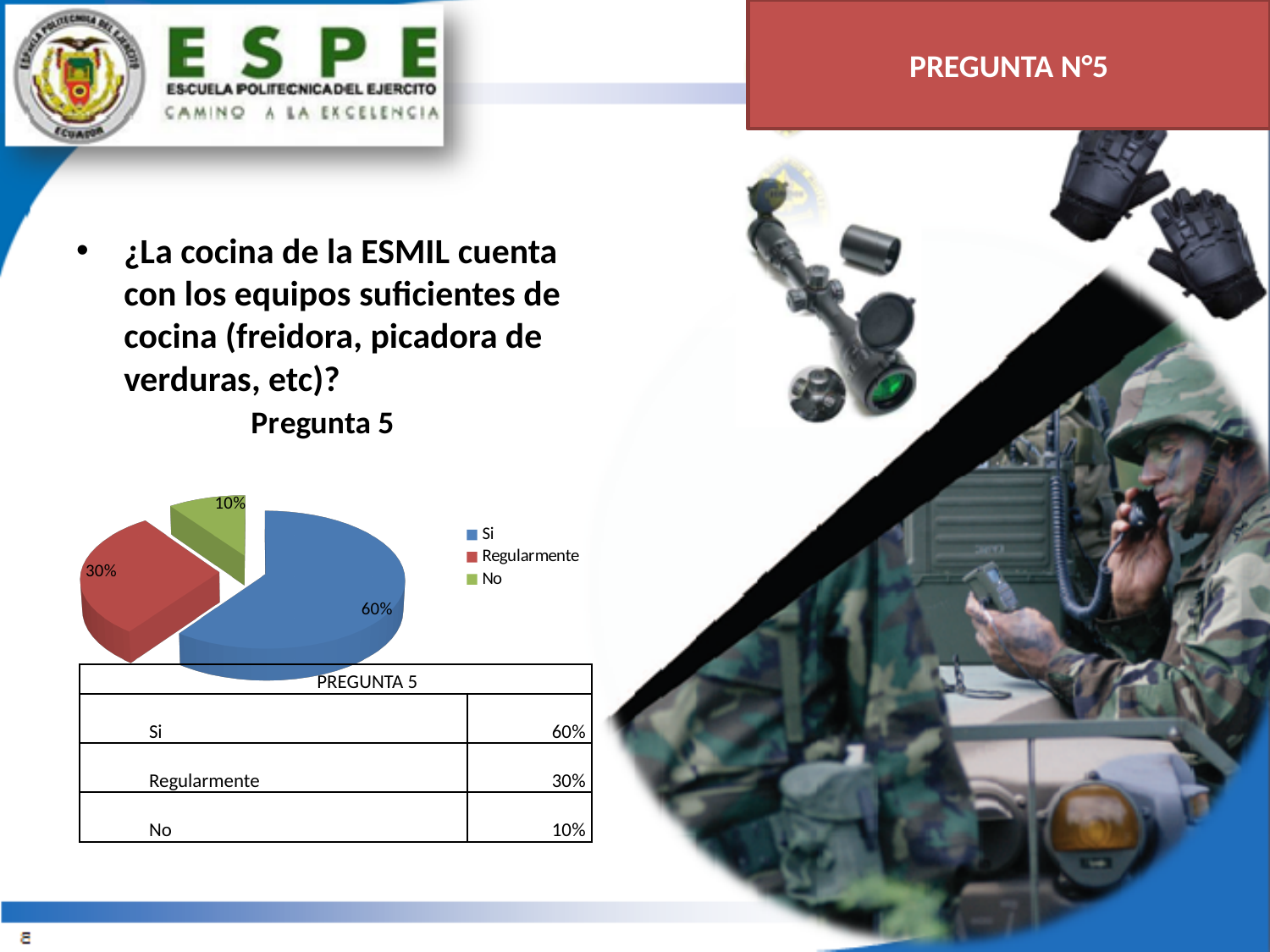
What is the value for No in the pie chart? 10% Which colour represents Regularmente in the pie chart? red What is the value for Regularmente in the pie chart? 30% What is the difference between the values for Si and Regularmente? 30% Which category has the smallest share of the pie chart? No What is the value for Si in the pie chart? 60% Which is larger, the value for Regularmente or the value for No? Regularmente What is the difference between the values for Regularmente and No? 20% What kind of chart is shown on the slide? pie chart How many categories does the pie chart have? 3 Which category has the largest share of the pie chart? Si What is the title of the chart? Pregunta 5